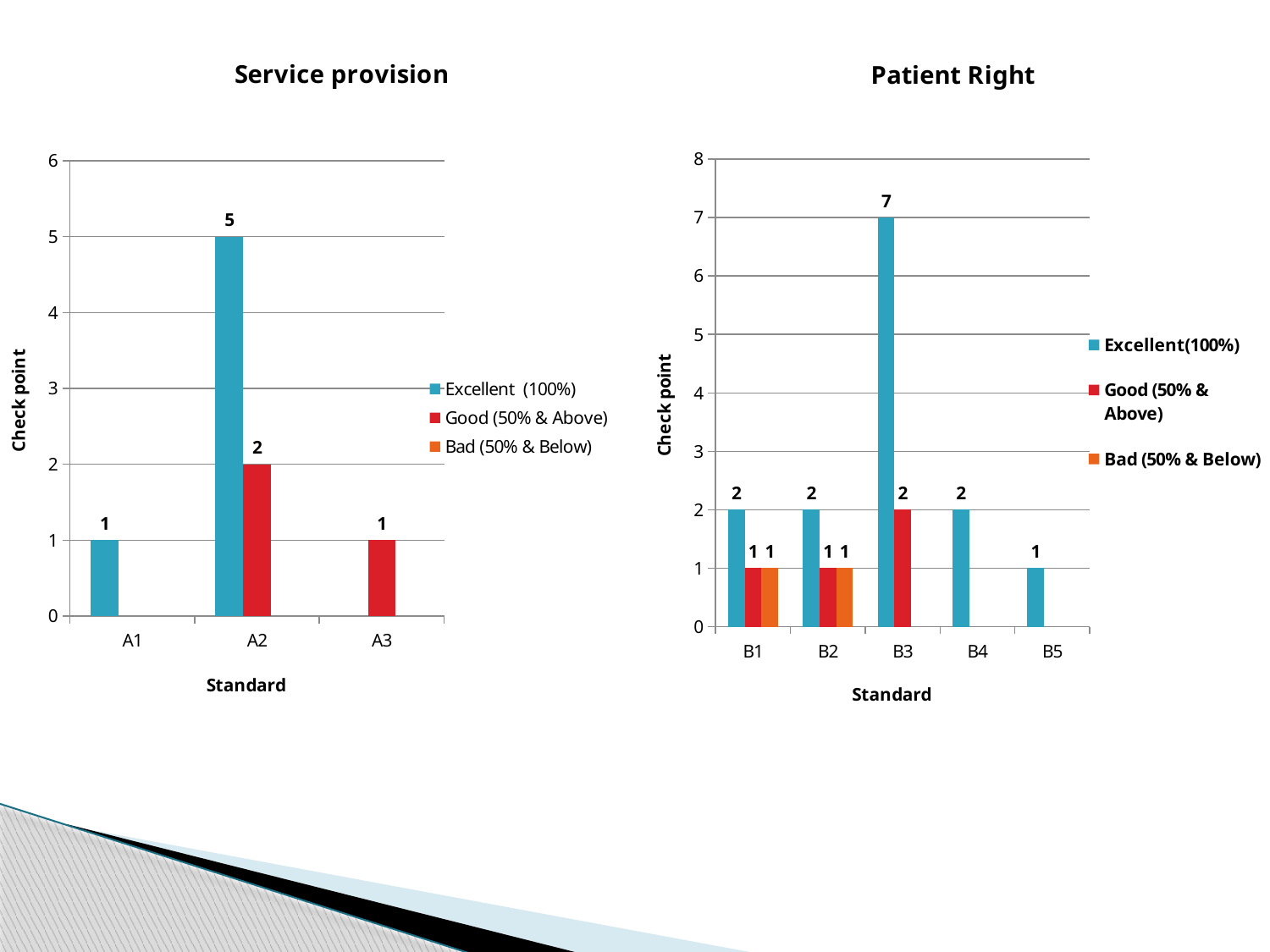
In the Patient Right chart, is the Excellent(100%) value for B3 larger than the Good (50% & Above) value for B3? Yes In the Service provision chart, how many series does the legend list? 3 In the Patient Right chart, which standard has the lowest Excellent(100%) value? B5 In the Patient Right chart, how many standards are shown on the x axis? 5 In the Service provision chart, what is the Excellent (100%) value for A2? 5 In the Service provision chart, which standard has the highest Excellent (100%) value? A2 In the Patient Right chart, which standard has the highest Excellent(100%) value? B3 In the Service provision chart, what is the difference between the Excellent (100%) and Good (50% & Above) values for A2? 3 In the Patient Right chart, what is the Excellent(100%) value for B3? 7 In the Service provision chart, what is the Good (50% & Above) value for A3? 1 What type of chart is the Patient Right chart? Bar chart In the Patient Right chart, what is the Bad (50% & Below) value for B2? 1